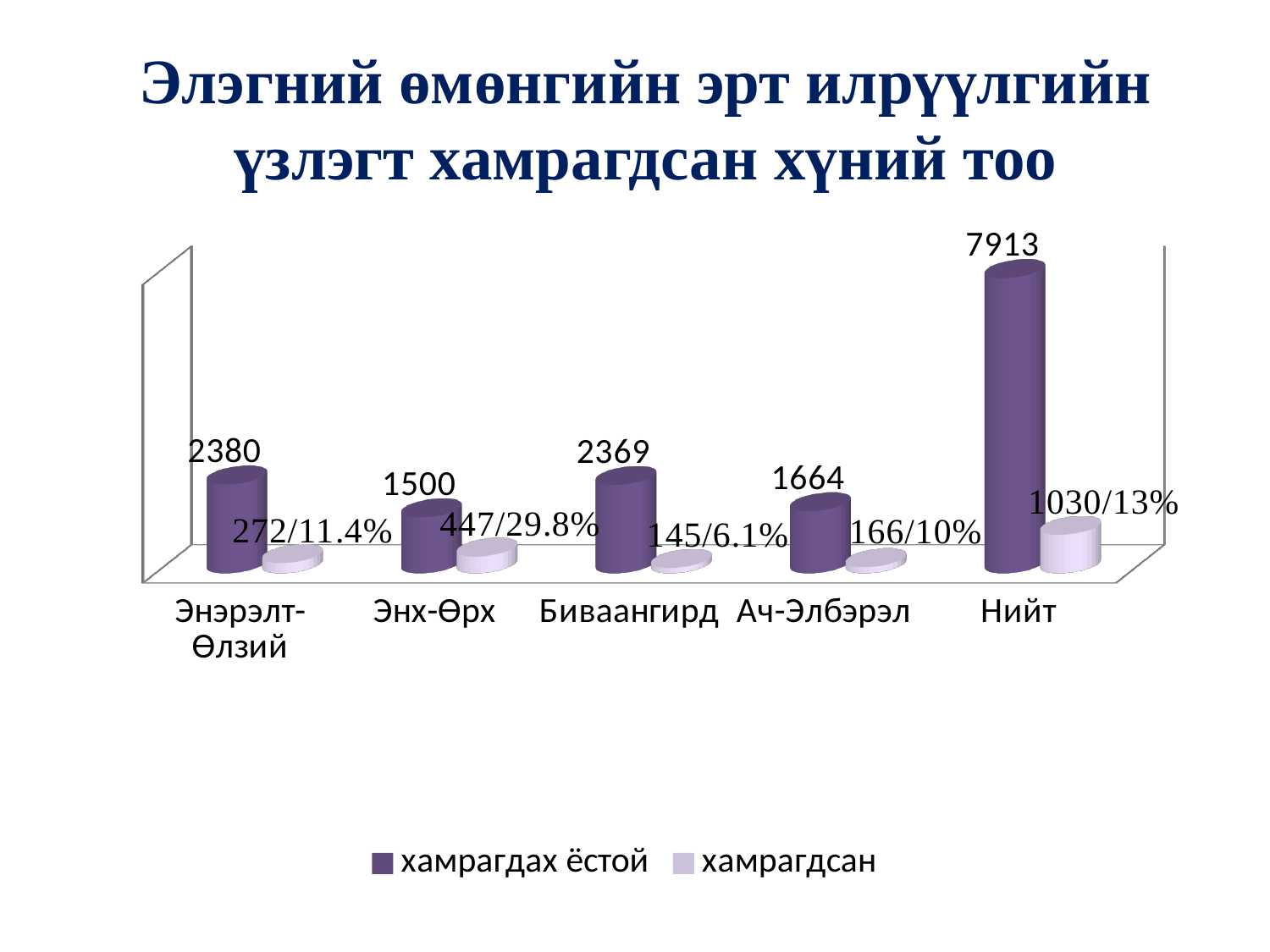
How many series does the legend list? 2 What is the data label shown for 'хамрагдсан' for Биваангирд? 145/6.1% Which category has the lowest 'хамрагдах ёстой' value? Энх-Өрх Which is larger, the 'хамрагдах ёстой' value for Ач-Элбэрэл or for Энх-Өрх? Ач-Элбэрэл How many categories are shown on the x axis? 5 What is the data label shown for 'хамрагдсан' for Энэрэлт-Өлзий? 272/11.4% What is the difference between the 'хамрагдах ёстой' values for Энэрэлт-Өлзий and Биваангирд? 11 What are the two series names listed in the legend? хамрагдах ёстой and хамрагдсан What is the value of 'хамрагдах ёстой' for Энх-Өрх? 1500 Which category has the highest 'хамрагдах ёстой' value? Нийт What is the value of 'хамрагдах ёстой' for Нийт? 7913 What kind of chart is shown on the slide? Bar chart